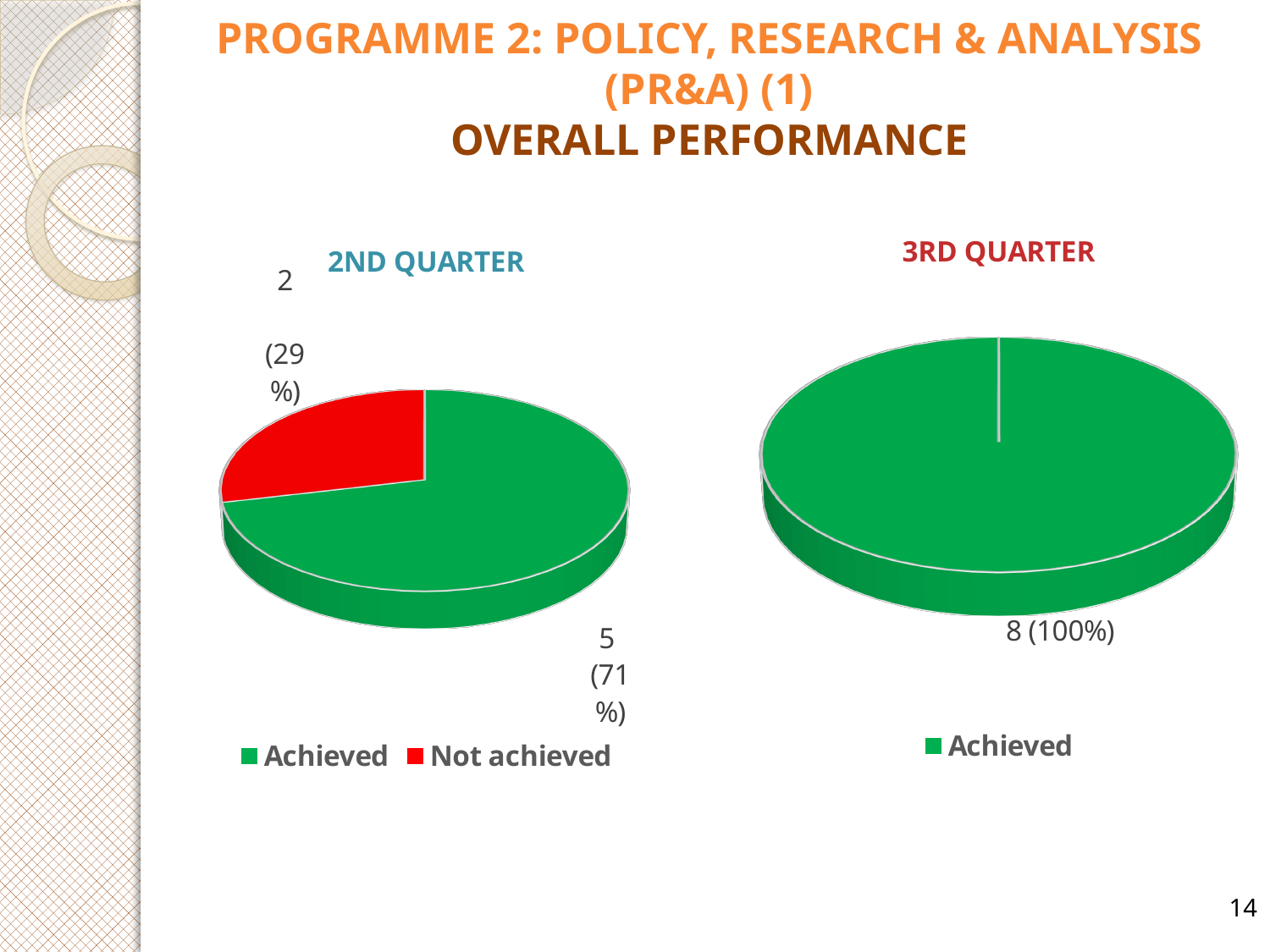
In the 2ND QUARTER chart, what percentage share does the Not achieved slice have? 29% In the 2ND QUARTER chart, which category is the smallest? Not achieved In the 2ND QUARTER chart, how many items were Achieved? 5 What type of chart is the 3RD QUARTER chart? Pie chart In the 2ND QUARTER chart, what percentage share does the Achieved slice have? 71% In the 2ND QUARTER chart, how many categories does the legend list? 2 In the 2ND QUARTER chart, which category is the largest? Achieved In the 2ND QUARTER chart, how many items were Not achieved? 2 In the 3RD QUARTER chart, what percentage share does the Achieved slice have? 100% In the 2ND QUARTER chart, what colour represents Not achieved? Red In the 3RD QUARTER chart, how many items were Achieved? 8 In the 2ND QUARTER chart, what is the difference between the Achieved and Not achieved counts? 3